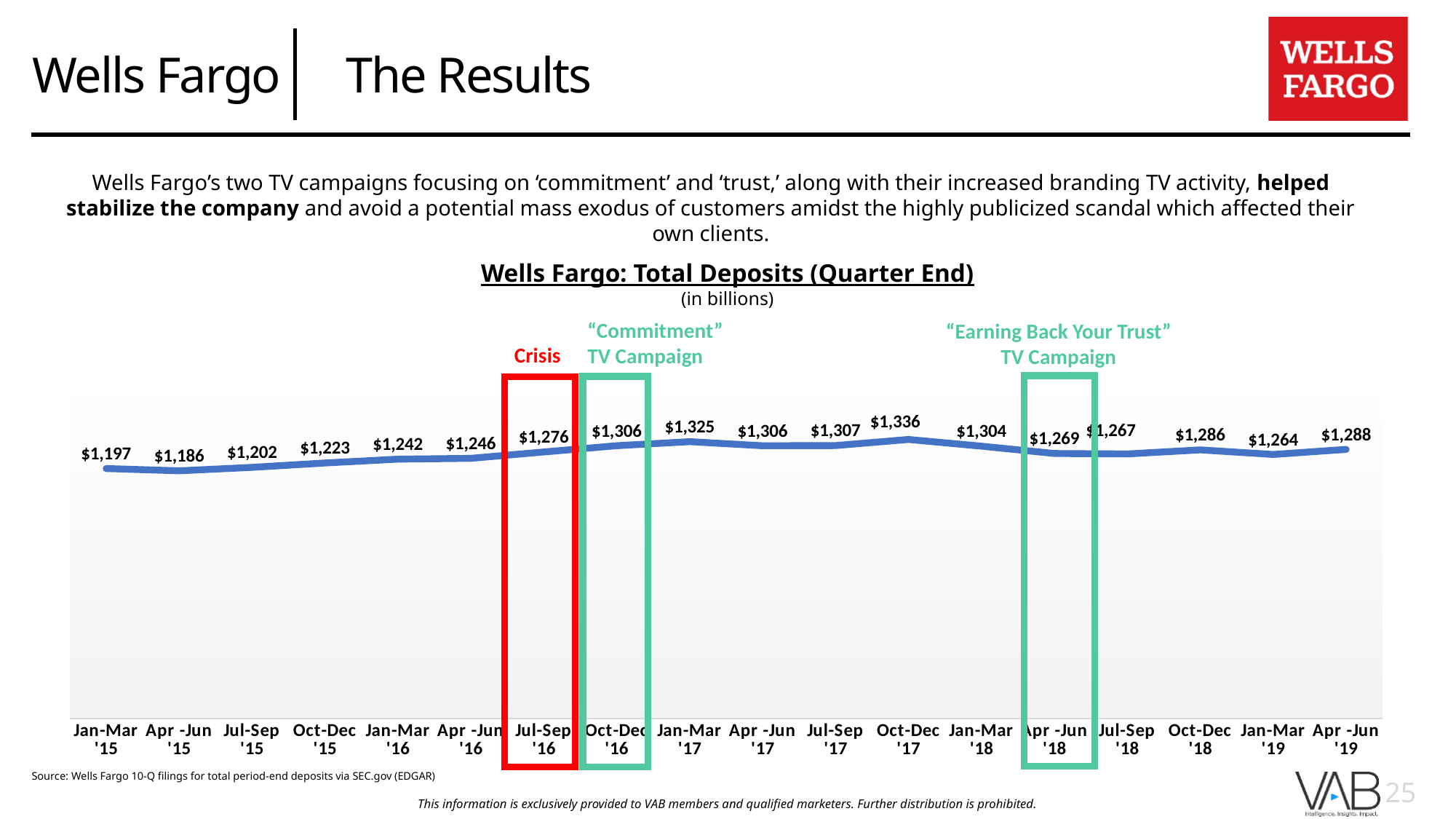
What is the difference in total deposits between Apr-Jun '19 and Jan-Mar '15? $91 What is the title of the chart? Wells Fargo: Total Deposits (Quarter End) What kind of chart is shown on the slide? line chart Which quarter had higher total deposits, Jan-Mar '17 or Jan-Mar '18? Jan-Mar '17 What were total deposits at the end of Oct-Dec '16, the quarter of the "Commitment" TV Campaign? $1,306 Which quarter had the highest total deposits? Oct-Dec '17 Did total deposits rise or fall from Jan-Mar '15 to Oct-Dec '17? rise What were total deposits at the end of Apr-Jun '18, the quarter of the "Earning Back Your Trust" TV Campaign? $1,269 What were Wells Fargo's total deposits at the end of Jul-Sep '16, the quarter marked as the Crisis? $1,276 How many quarters are plotted on the chart? 18 Which quarter had the lowest total deposits? Apr-Jun '15 In what unit are the deposit values on the chart expressed? in billions